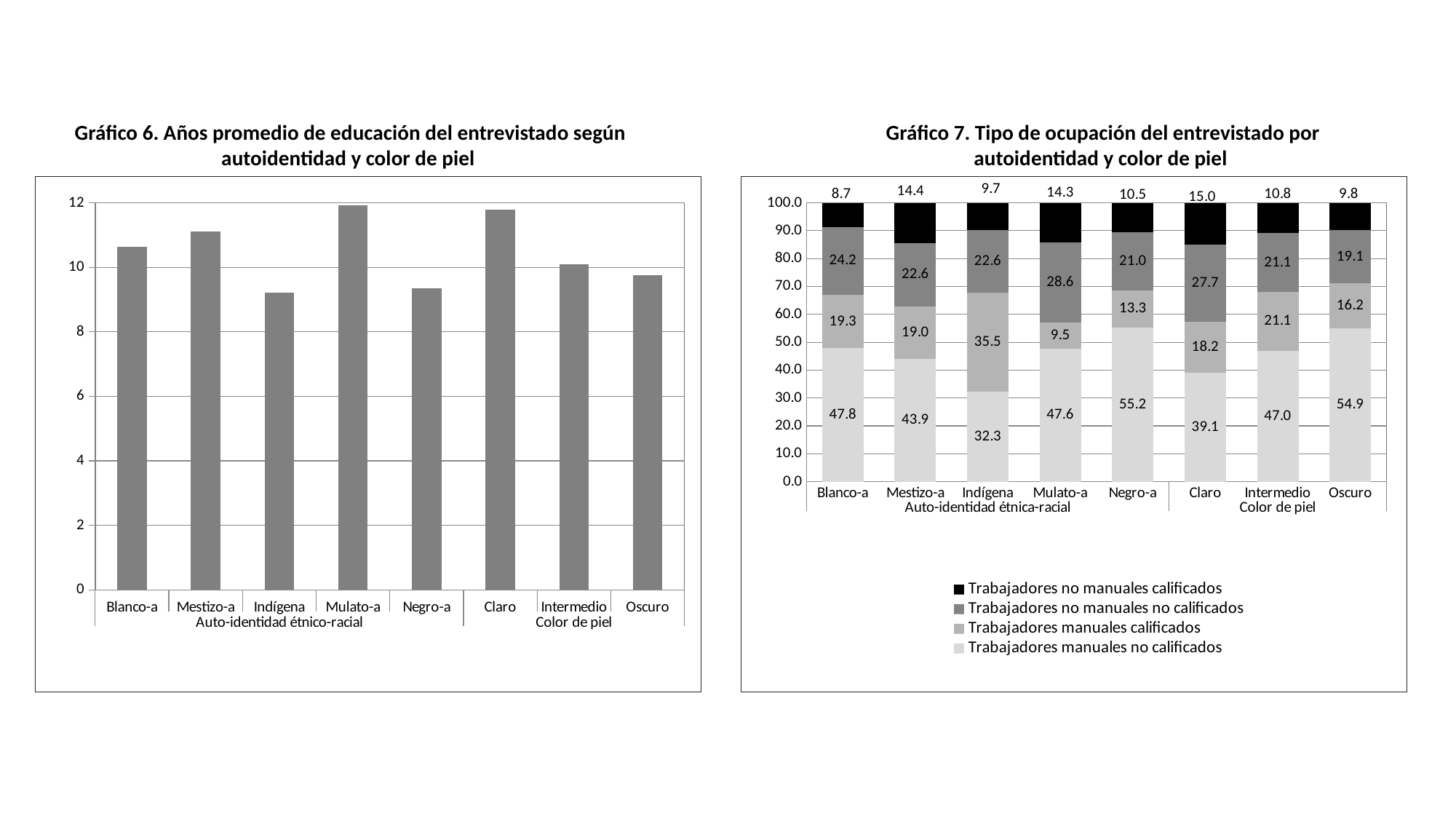
How many series does the legend of Gráfico 7 list? 4 What kind of chart is Gráfico 6 (the left chart)? Bar chart In Gráfico 6, is the value for Oscuro greater or less than 10? less In Gráfico 7, which category has the lowest value for Trabajadores manuales calificados? Mulato-a In Gráfico 6, which is larger, the value for Mestizo-a or the value for Indígena? Mestizo-a In Gráfico 7, what is the value for Trabajadores no manuales calificados for Claro? 15.0 In Gráfico 6, how many categories are shown on the x axis? 8 In Gráfico 6, is the value for Mulato-a greater or less than 10? greater In Gráfico 7, what is the difference between the Trabajadores manuales no calificados values for Blanco-a and Mestizo-a? 3.9 In Gráfico 7, what is the value for Trabajadores manuales no calificados for Indígena? 32.3 In Gráfico 7, which category has the highest value for Trabajadores manuales no calificados? Negro-a In Gráfico 6, is the value for Indígena greater or less than 10? less